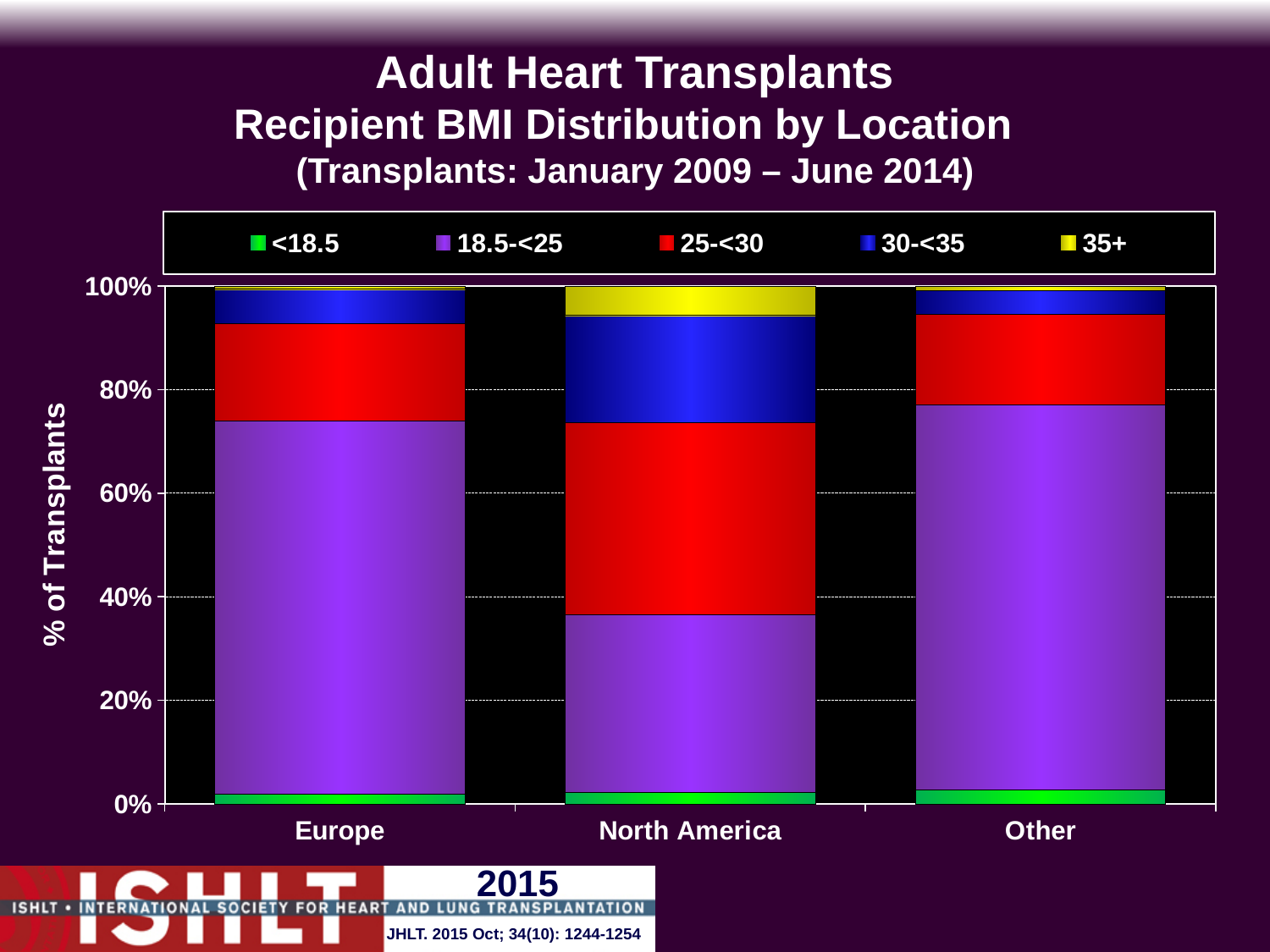
How many locations are shown on the x axis of the chart? 3 What kind of chart is shown on the slide? Stacked bar chart Which location has the largest share of recipients with BMI 30-<35? North America What is the title of the chart? Adult Heart Transplants Recipient BMI Distribution by Location (Transplants: January 2009 – June 2014) How many BMI categories does the legend list? 5 Is the share of recipients with BMI 18.5-<25 in North America greater or less than 40%? less Which is larger: the share of recipients with BMI 35+ in North America or in Europe? North America Which location has the smallest share of recipients with BMI 18.5-<25? North America Is the share of recipients with BMI 18.5-<25 in Europe greater or less than 60%? greater Which is larger: the share of recipients with BMI 18.5-<25 in Europe or in North America? Europe What is the label of the y axis? % of Transplants Which location has the largest share of recipients with BMI 25-<30? North America